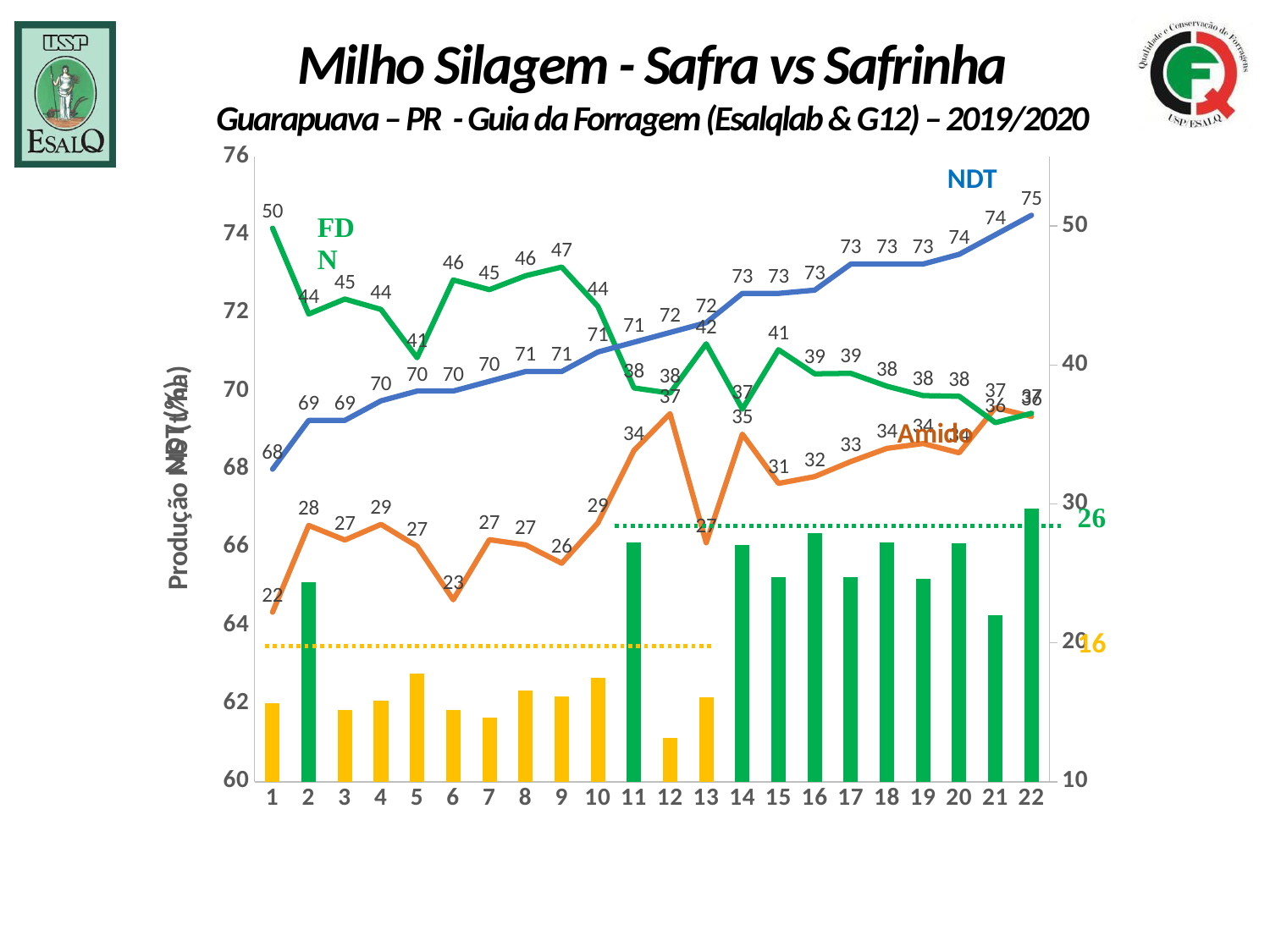
What is the NDT value at point 22? 75 What is the Amido value at point 6? 23 Does the NDT line rise or fall from point 1 to point 22? Rises What is the NDT value at point 1? 68 What is the Amido value at point 12? 37 What is the difference between the NDT value at point 22 and at point 1? 7 Is the bar at point 12 greater or less than 20 on the right axis? less How many points are shown on the x axis? 22 What colour is the NDT line? Blue Which has the higher FDN value, point 1 or point 13? Point 1 At which point is the Amido line lowest? 1 At which point is the FDN line highest? 1